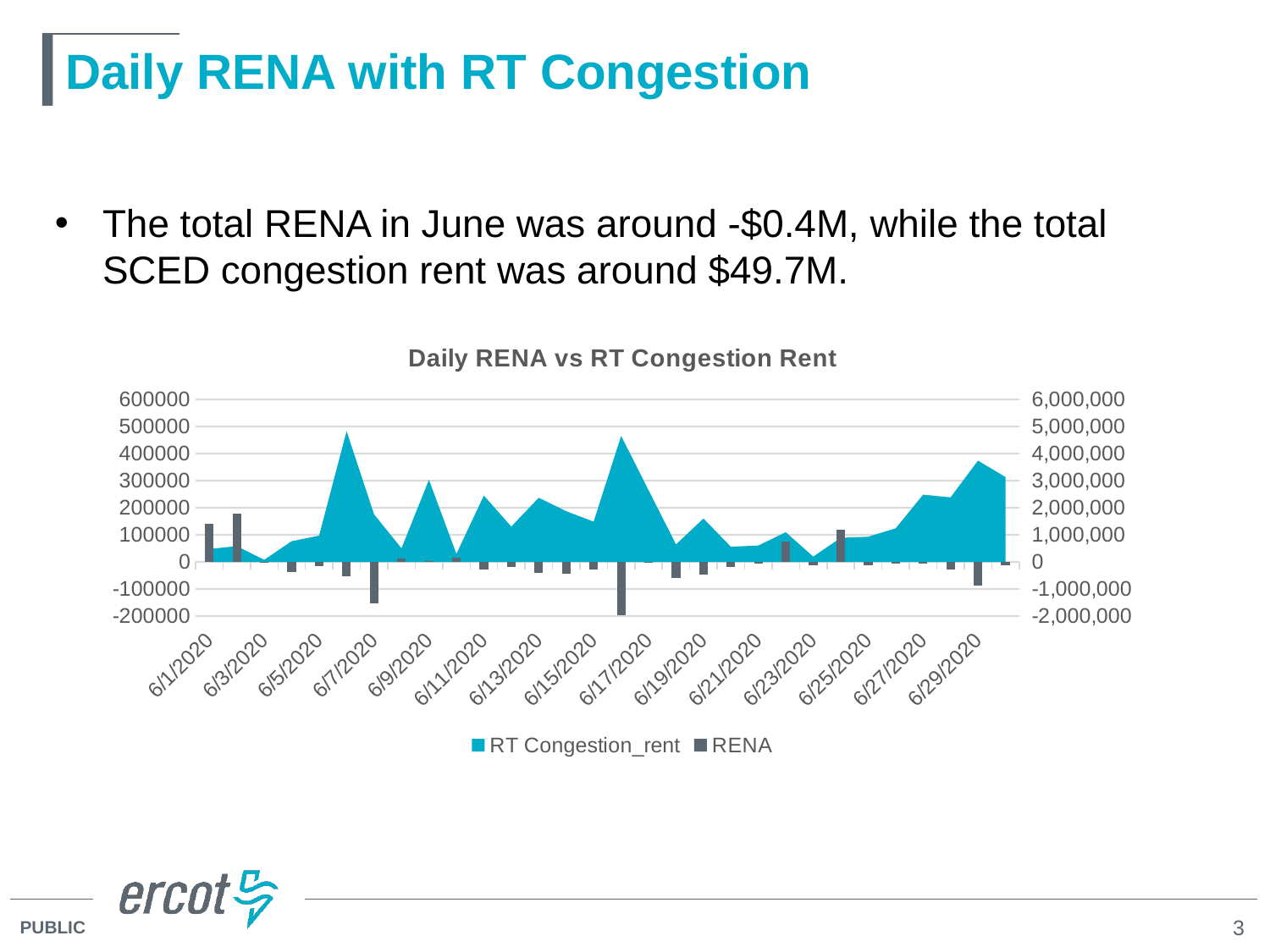
What is the title of the chart on the slide? Daily RENA vs RT Congestion Rent Does the RT Congestion_rent series rise or fall from 6/25/2020 to 6/29/2020? rise What are the names of the two series in the chart legend? RT Congestion_rent and RENA Which date has the larger RT Congestion_rent value, 6/5/2020 or 6/7/2020? 6/7/2020 Which date has the larger RENA value, 6/1/2020 or 6/3/2020? 6/1/2020 How many date labels are shown along the x axis of the chart? 15 What kind of chart is shown on the slide? A combination chart with an area series and a bar series How many series does the chart legend list? 2